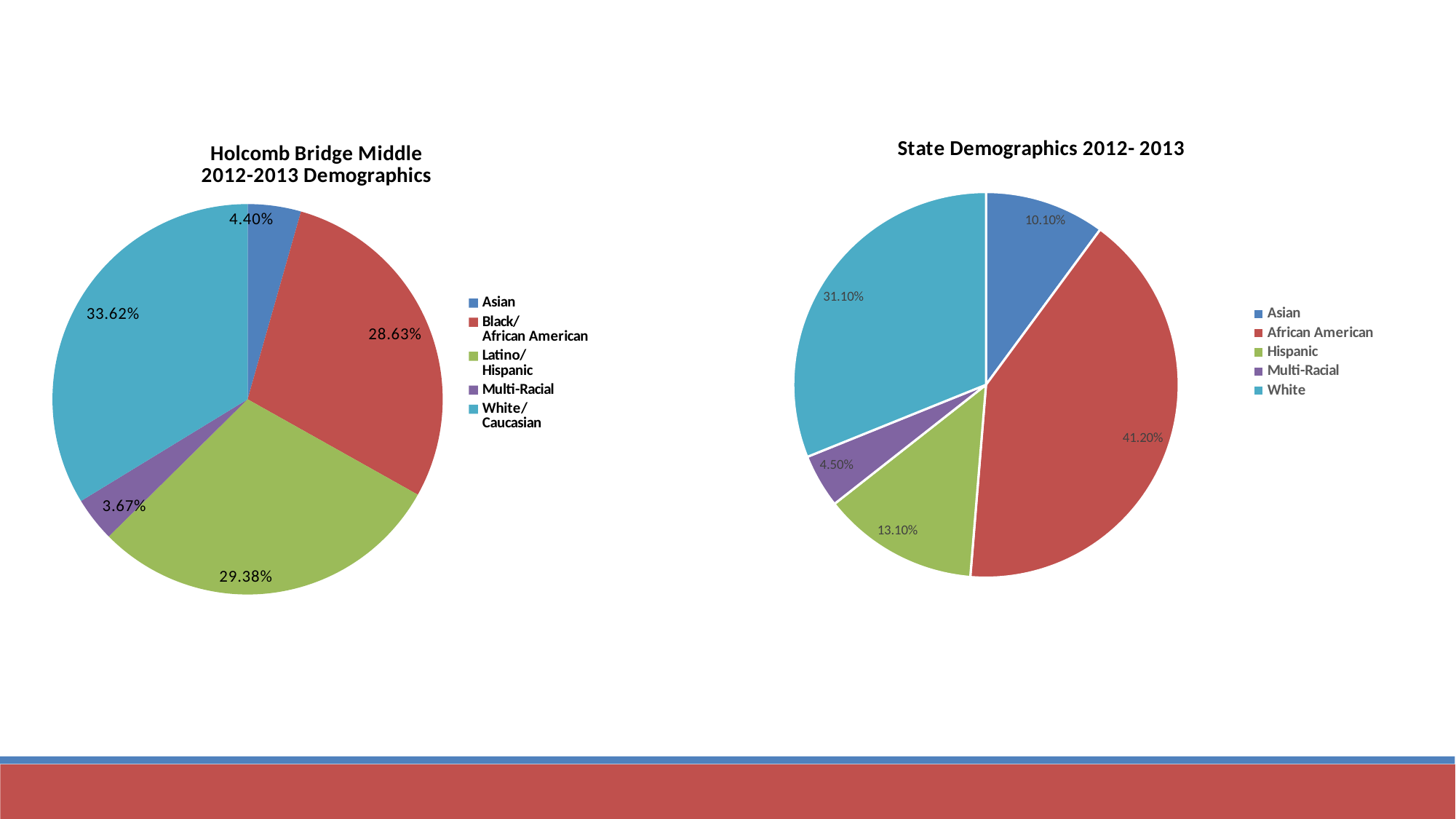
In the State Demographics 2012- 2013 chart, which is larger, the White slice or the Hispanic slice? White In the State Demographics 2012- 2013 chart, what is the difference between the African American and White shares? 10.10% How many categories does the legend of the State Demographics 2012- 2013 chart list? 5 In the State Demographics 2012- 2013 chart, what share is labelled for Asian? 10.10% What kind of chart is the Holcomb Bridge Middle 2012-2013 Demographics chart? Pie chart In the Holcomb Bridge Middle 2012-2013 Demographics chart, which category has the largest slice? White/Caucasian In the Holcomb Bridge Middle 2012-2013 Demographics chart, what share is labelled for Multi-Racial? 3.67% In the Holcomb Bridge Middle 2012-2013 Demographics chart, what is the difference between the White/Caucasian and Black/African American shares? 4.99% In the State Demographics 2012- 2013 chart, which category has the smallest slice? Multi-Racial In the Holcomb Bridge Middle 2012-2013 Demographics chart, which category has the smallest slice? Multi-Racial In the State Demographics 2012- 2013 chart, what share is labelled for African American? 41.20% In the Holcomb Bridge Middle 2012-2013 Demographics chart, what share is labelled for Latino/Hispanic? 29.38%